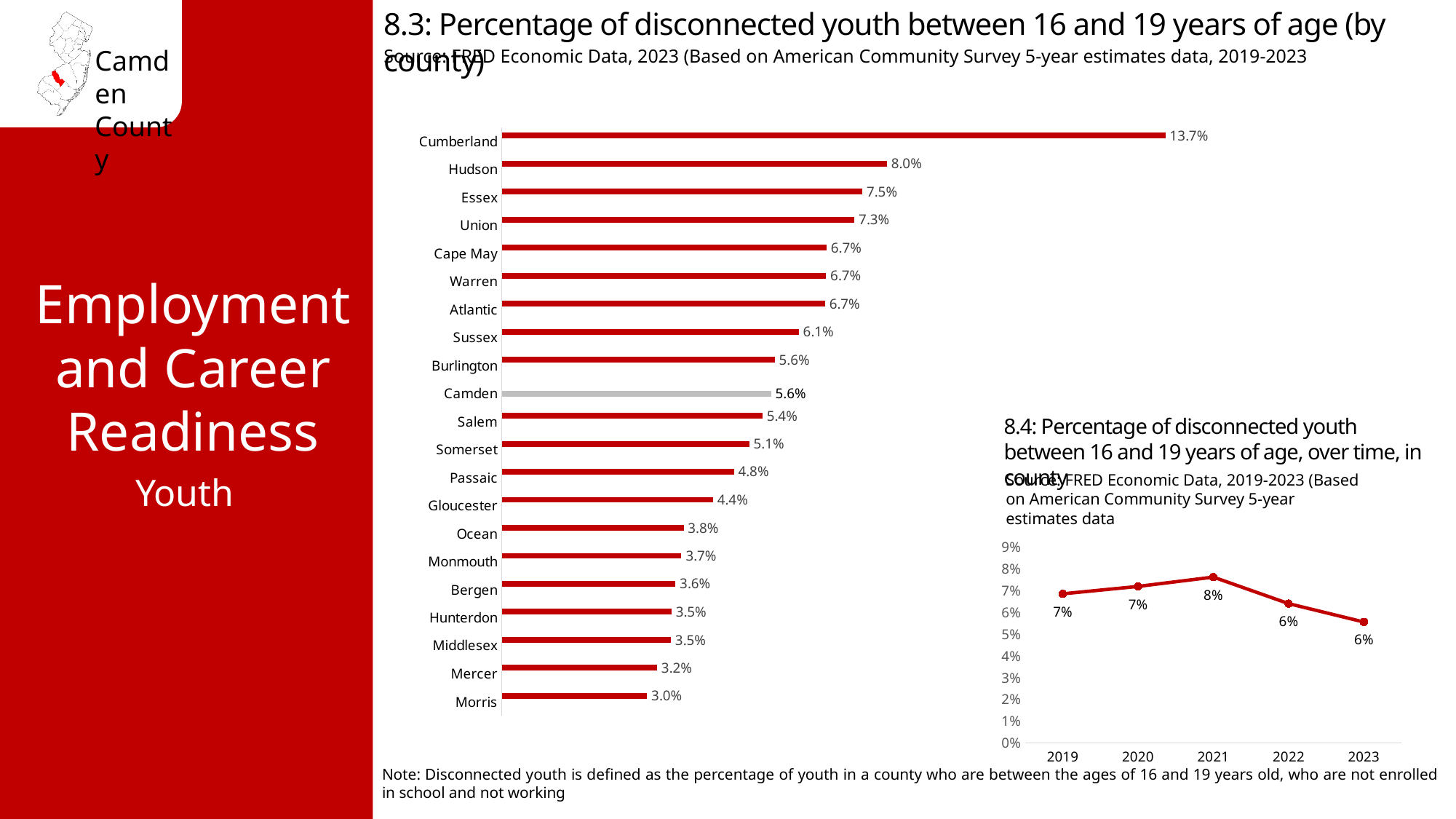
In chart 8.3 (by county), which county has the highest percentage of disconnected youth? Cumberland In chart 8.3 (by county), how many counties are shown? 21 In chart 8.3 (by county), what is the difference between Cumberland and Hudson? 5.7% In chart 8.3 (by county), which county has the lowest percentage of disconnected youth? Morris In chart 8.3 (by county), which is larger, the value for Gloucester or the value for Ocean? Gloucester In chart 8.3 (by county), what is the value for Camden? 5.6% In chart 8.3 (by county), what is the value for Cumberland? 13.7% What kind of chart is chart 8.3 (by county)? Bar chart In chart 8.3 (by county), what is the value for Mercer? 3.2% In chart 8.4 (over time), what is the value for 2021? 8% In chart 8.4 (over time), how many data points are plotted? 5 In chart 8.4 (over time), which year has the highest value? 2021